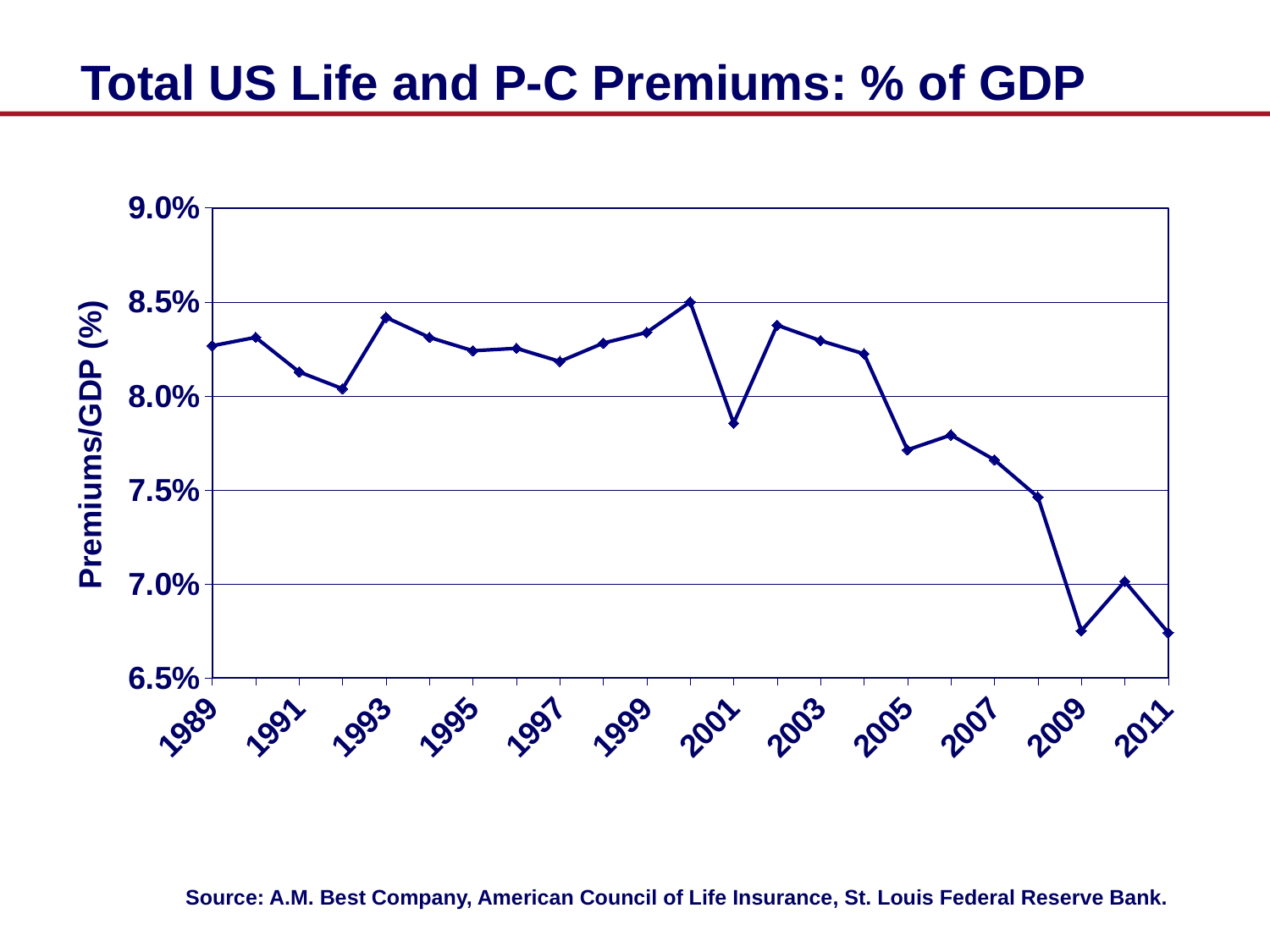
Which year has the larger value, 2000 or 2001? 2000 Is the value for 2009 greater or less than 7.0%? less Is the value for 2007 greater or less than 7.5%? greater Is the value for 1993 greater or less than 8.0%? greater What is the label on the vertical axis? Premiums/GDP (%) What kind of chart is shown on the slide? line chart Overall, do the values rise or fall from 1989 to 2011? fall How many year labels are shown on the x axis? 12 What is the title of the chart? Total US Life and P-C Premiums: % of GDP In which year does the line reach its highest value? 2000